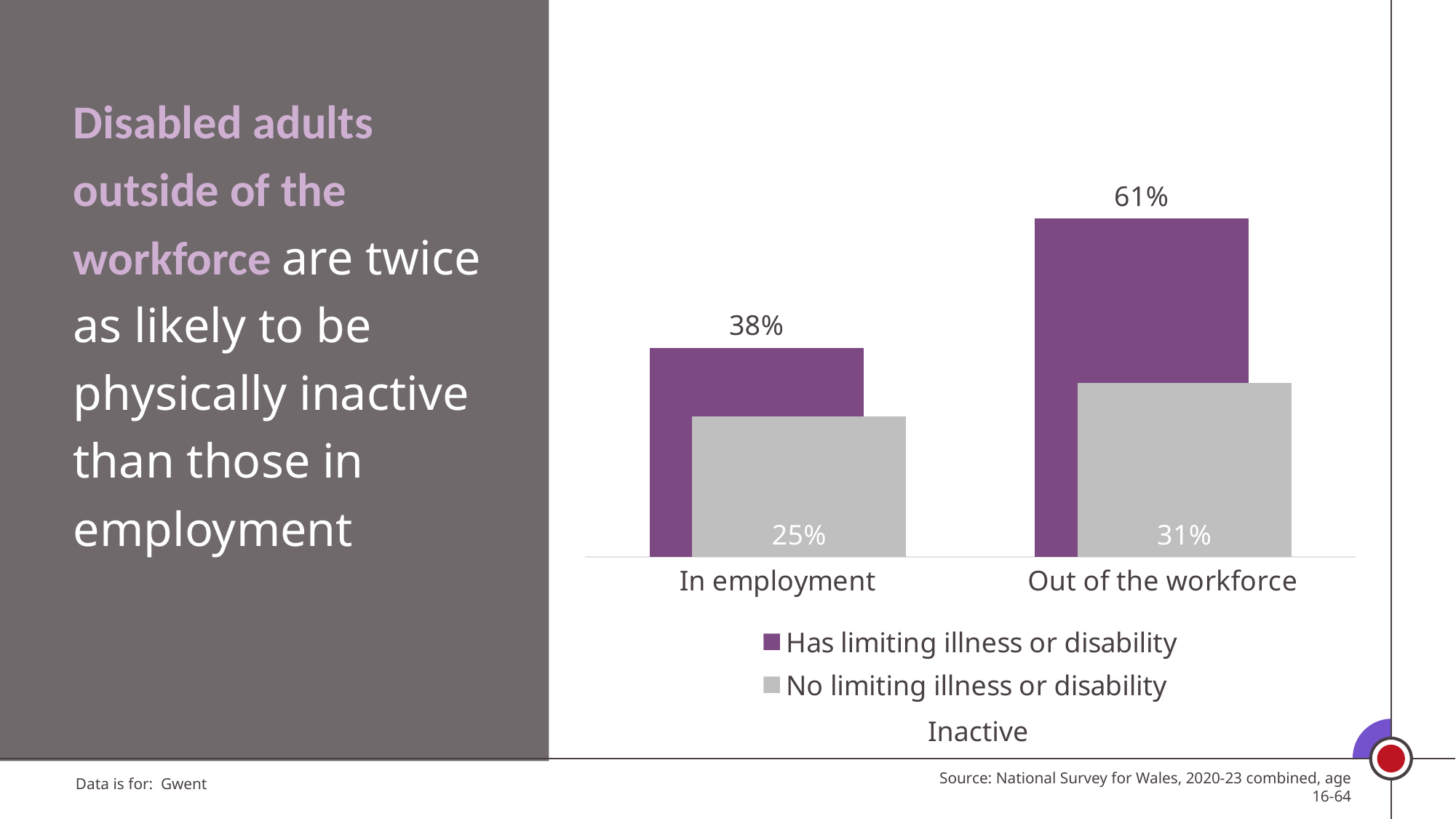
Which is larger: 'Has limiting illness or disability' for 'In employment' or 'No limiting illness or disability' for 'Out of the workforce'? Has limiting illness or disability for In employment What is the value for 'Has limiting illness or disability' in the 'In employment' category? 38% How many categories are shown on the x axis? 2 What is the difference between the 'Has limiting illness or disability' values for 'Out of the workforce' and 'In employment'? 23% What is the value for 'No limiting illness or disability' in the 'Out of the workforce' category? 31% What is the difference between the 'Has limiting illness or disability' and 'No limiting illness or disability' values in the 'Out of the workforce' category? 30% Which category has the lowest value for 'No limiting illness or disability'? In employment What kind of chart is shown on the slide? Bar chart What is the value for 'Has limiting illness or disability' in the 'Out of the workforce' category? 61% What is the value for 'No limiting illness or disability' in the 'In employment' category? 25% Which category has the highest value for 'Has limiting illness or disability'? Out of the workforce How many series does the legend list? 2